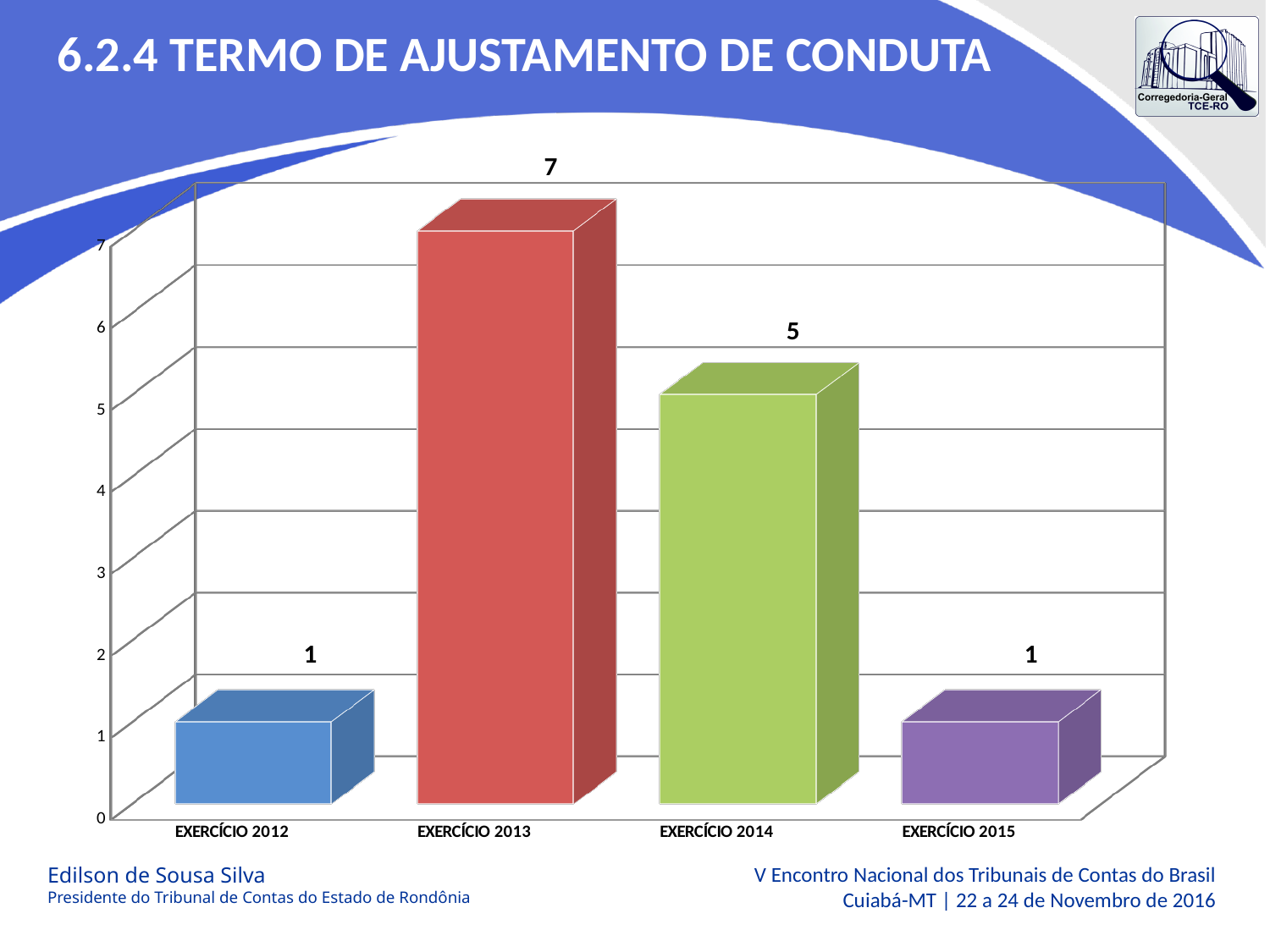
What is the value for EXERCÍCIO 2014? 5 What is the difference between the values for EXERCÍCIO 2014 and EXERCÍCIO 2015? 4 What kind of chart is shown on the slide? bar chart What is the value for EXERCÍCIO 2013? 7 What is the value for EXERCÍCIO 2015? 1 Which category has the highest value? EXERCÍCIO 2013 What colour is the bar for EXERCÍCIO 2013? red How many categories are shown on the x axis? 4 Is the value for EXERCÍCIO 2014 greater or less than 3? greater What is the value for EXERCÍCIO 2012? 1 Which is larger, the value for EXERCÍCIO 2013 or the value for EXERCÍCIO 2014? EXERCÍCIO 2013 What is the difference between the values for EXERCÍCIO 2013 and EXERCÍCIO 2014? 2